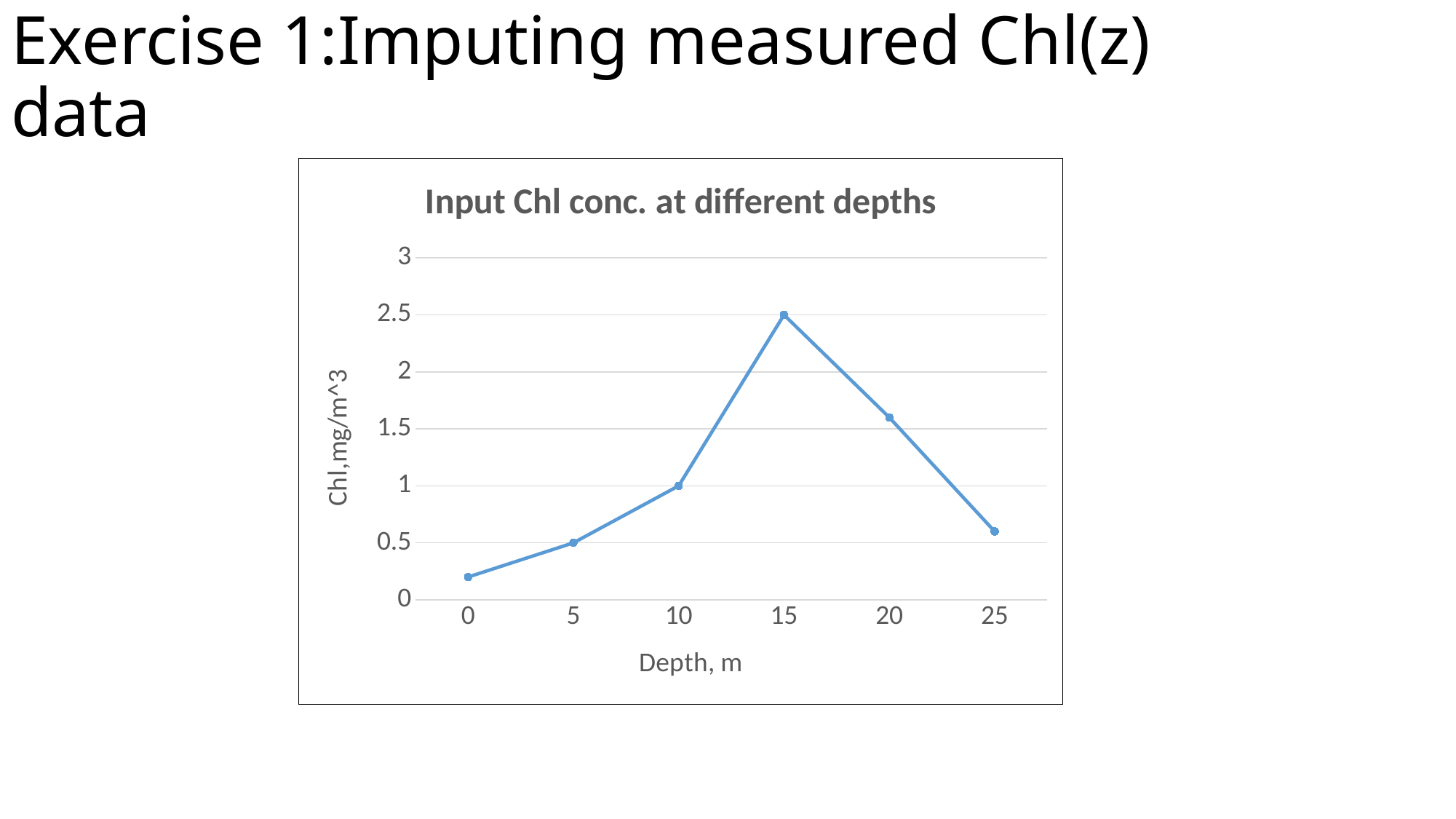
What is the title of the chart? Input Chl conc. at different depths At which depth is the Chl concentration highest? 15 Is the Chl concentration at a depth of 25 m greater or less than 1? less How many data points are plotted on the line? 6 Which depth has a larger Chl concentration, 10 m or 20 m? 20 m What is the difference between the Chl concentration at 15 m and at 10 m? 1.5 What is the Chl concentration at a depth of 5 m? 0.5 Is the Chl concentration at a depth of 20 m greater or less than 1.5? greater At which depth is the Chl concentration lowest? 0 What is the Chl concentration at a depth of 15 m? 2.5 What kind of chart is shown on the slide? line chart What is the Chl concentration at a depth of 10 m? 1